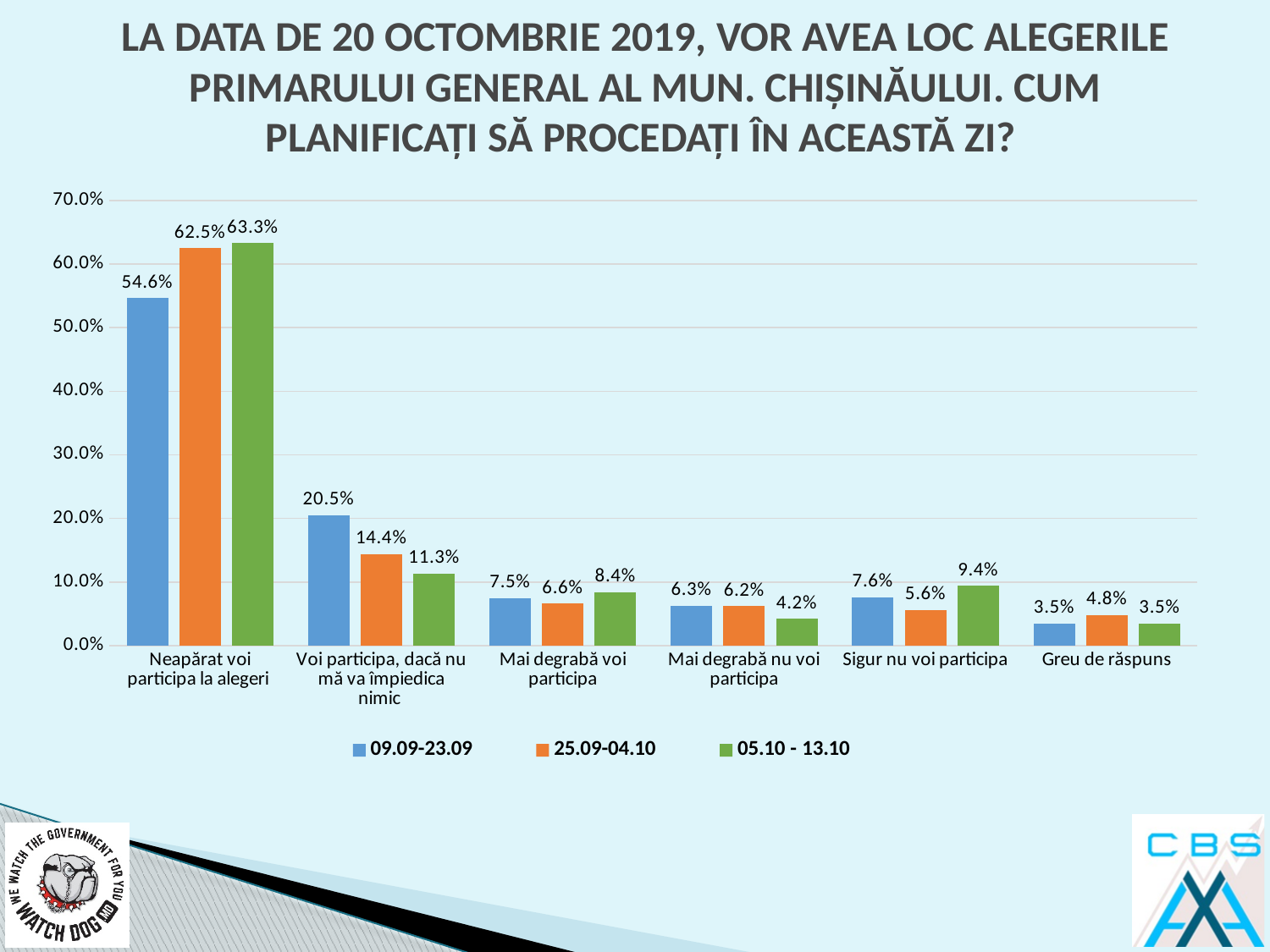
What is the difference between the 05.10 - 13.10 and 09.09-23.09 values for "Neapărat voi participa la alegeri"? 8.7% Which colour represents the 25.09-04.10 series? Orange Which category has the highest value in the 09.09-23.09 series? Neapărat voi participa la alegeri How many categories are shown on the x axis? 6 What is the value for "Voi participa, dacă nu mă va împiedica nimic" in the 09.09-23.09 series? 20.5% Which is larger for "Mai degrabă voi participa": the 09.09-23.09 value or the 05.10 - 13.10 value? 05.10 - 13.10 What is the value for "Sigur nu voi participa" in the 25.09-04.10 series? 5.6% Which category has the lowest value in the 05.10 - 13.10 series? Greu de răspuns What is the value for "Neapărat voi participa la alegeri" in the 05.10 - 13.10 series? 63.3% What kind of chart is shown on the slide? Bar chart Across the three survey periods, do the values for "Voi participa, dacă nu mă va împiedica nimic" rise or fall? Fall How many series does the legend list? 3